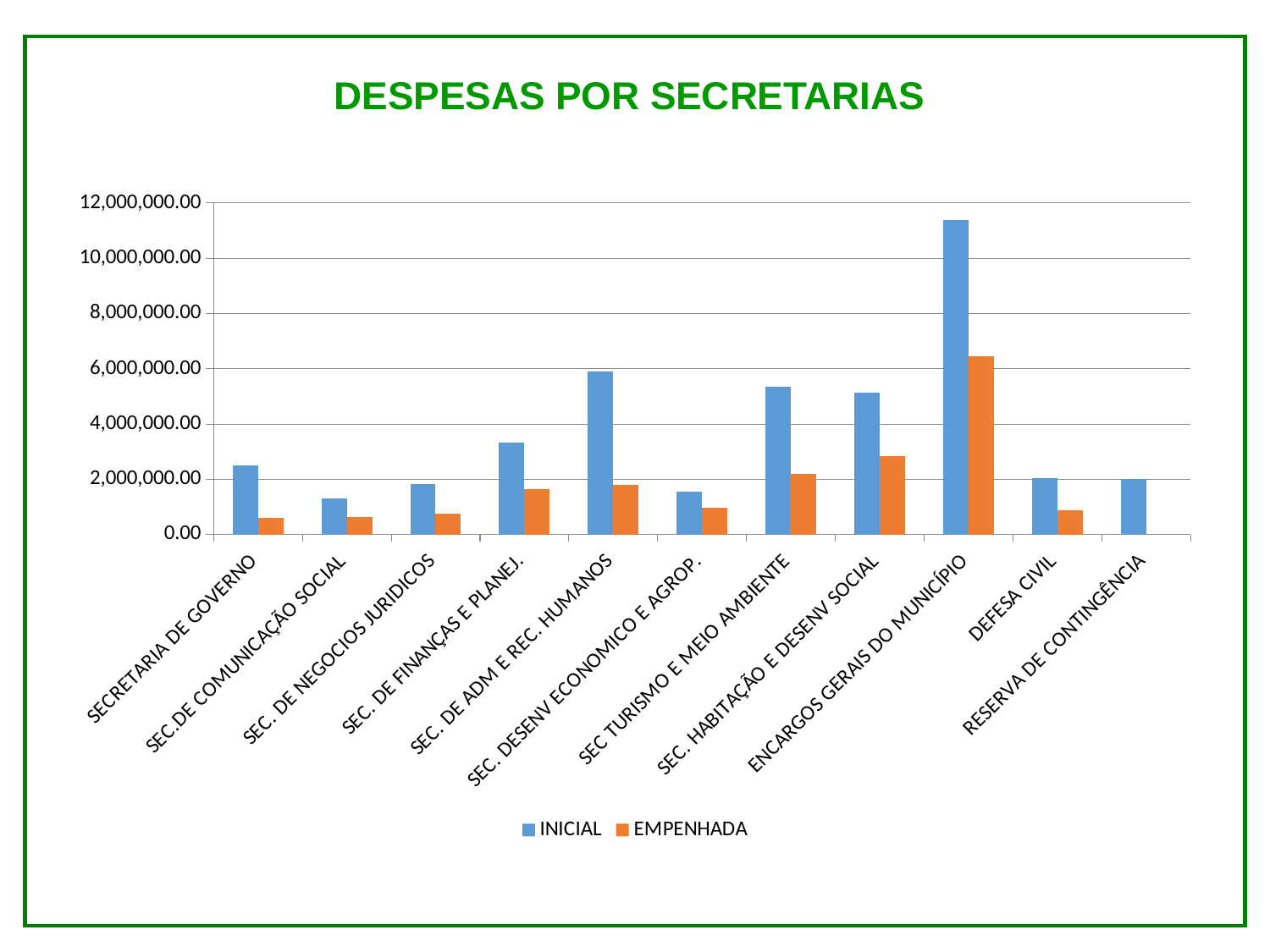
Is the EMPENHADA value for ENCARGOS GERAIS DO MUNICÍPIO greater or less than 6,000,000.00? greater What is the title of the chart? DESPESAS POR SECRETARIAS What type of chart is shown on the slide? bar chart Is the EMPENHADA value for DEFESA CIVIL greater or less than 2,000,000.00? less Which category has the highest INICIAL value? ENCARGOS GERAIS DO MUNICÍPIO How many categories (secretarias) are shown on the x axis? 11 Is the INICIAL value for ENCARGOS GERAIS DO MUNICÍPIO greater or less than 10,000,000.00? greater Which category has the highest EMPENHADA value? ENCARGOS GERAIS DO MUNICÍPIO Which is larger, the INICIAL value for SEC. DE ADM E REC. HUMANOS or the INICIAL value for SEC TURISMO E MEIO AMBIENTE? SEC. DE ADM E REC. HUMANOS How many series does the legend list? 2 Which series is shown in orange? EMPENHADA